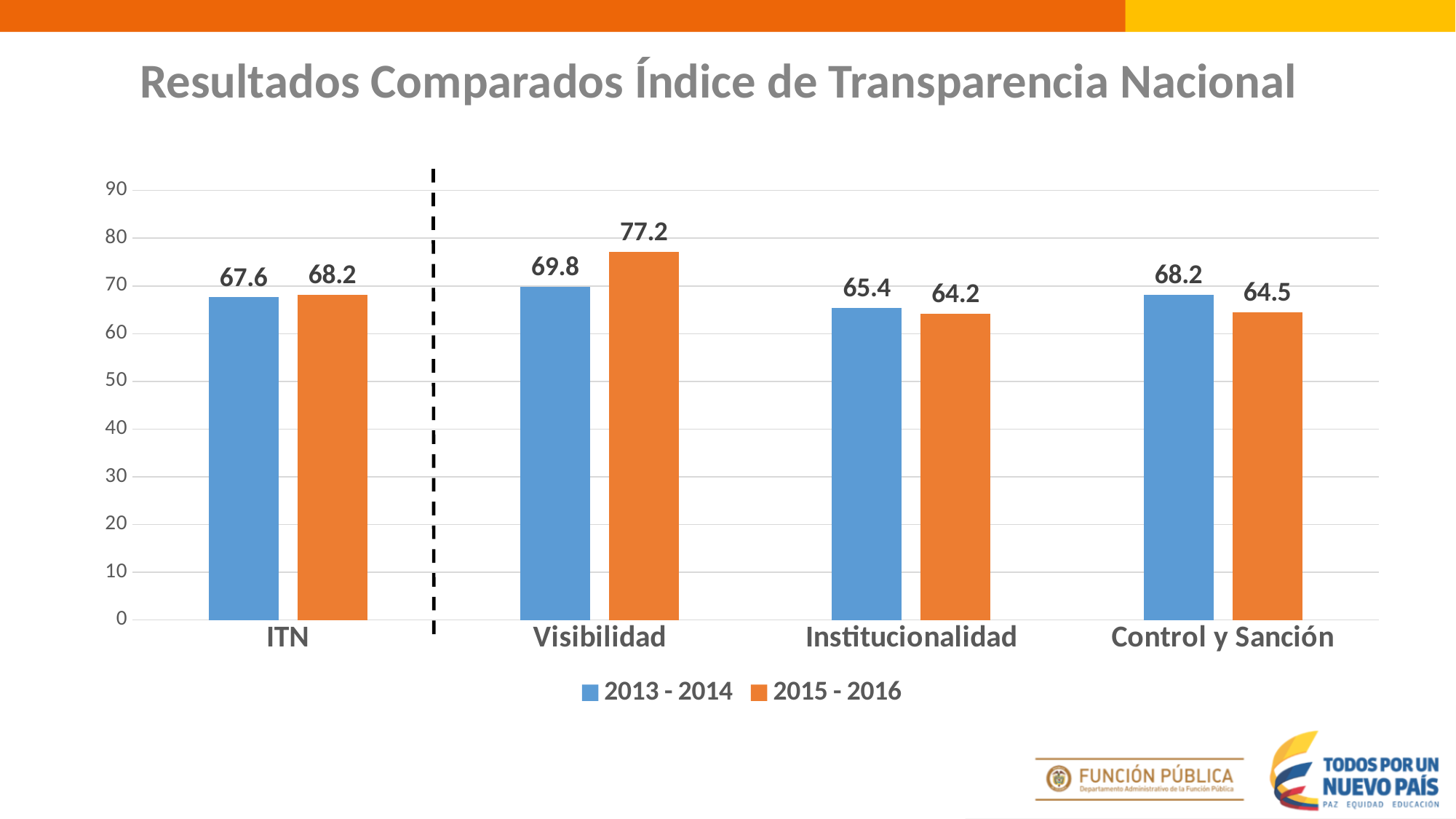
What is the value for Control y Sanción in the 2015 - 2016 series? 64.5 What kind of chart is shown on the slide? Bar chart Which category has the lowest value in the 2015 - 2016 series? Institucionalidad What is the title of the slide? Resultados Comparados Índice de Transparencia Nacional How many series does the legend list? 2 What is the value for Visibilidad in the 2015 - 2016 series? 77.2 What is the value for Institucionalidad in the 2013 - 2014 series? 65.4 What is the value for ITN in the 2015 - 2016 series? 68.2 For Control y Sanción, which series has the larger value, 2013 - 2014 or 2015 - 2016? 2013 - 2014 Which category has the highest value in the 2015 - 2016 series? Visibilidad What is the difference between the 2015 - 2016 and 2013 - 2014 values for Visibilidad? 7.4 How many categories are shown on the x axis? 4